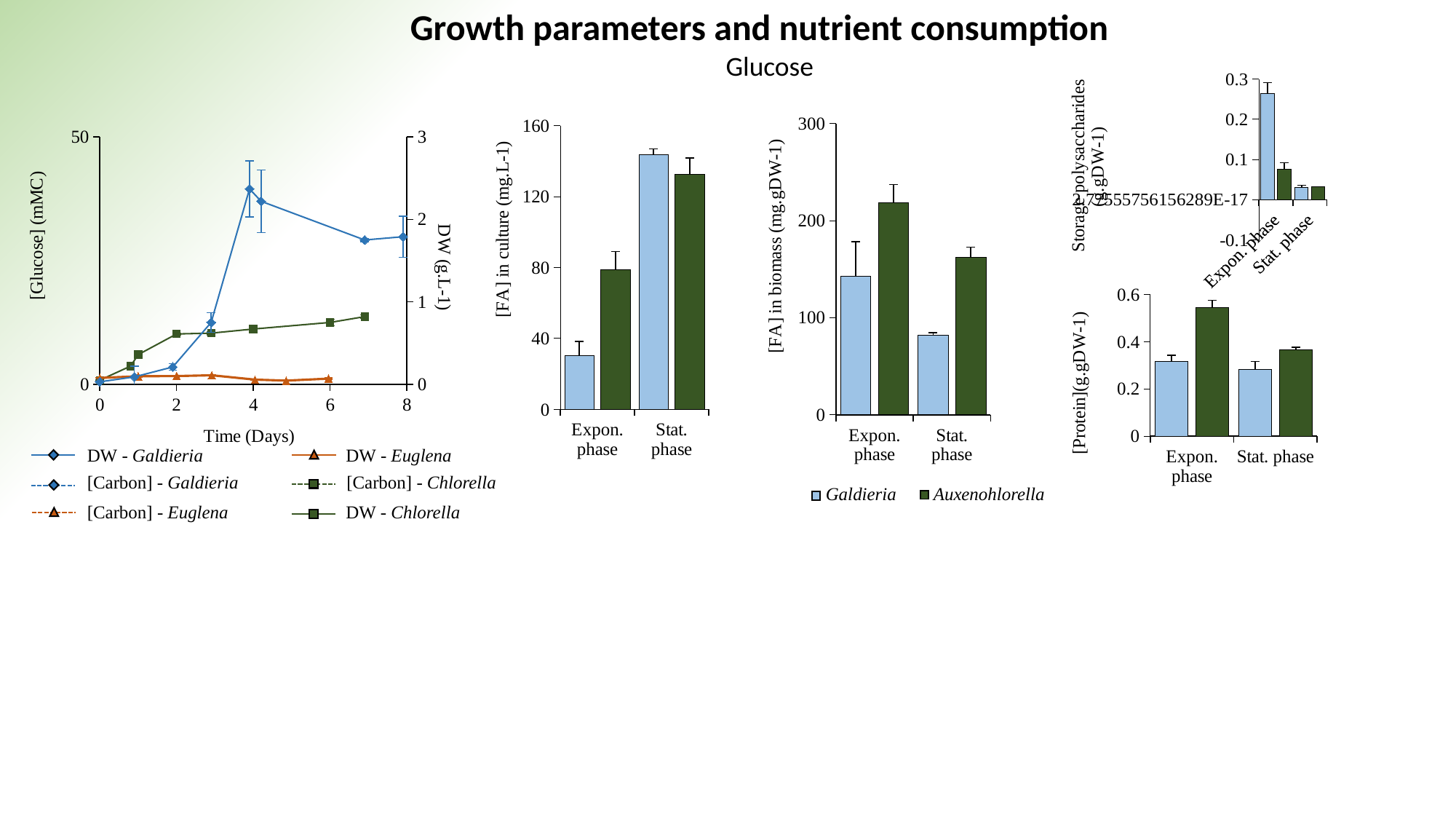
In the Storage polysaccharides (g.gDW-1) bar chart, is the Galdieria value in the Expon. phase greater or less than 0.2? greater In the leftmost line chart, what is the x-axis title? Time (Days) In the [FA] in biomass (mg.gDW-1) bar chart, which species has the larger value in the Expon. phase? Auxenohlorella In the [FA] in culture (mg.L-1) bar chart, is the Galdieria value in the Expon. phase greater or less than 40? less In the [Protein] (g.gDW-1) bar chart, how many phase categories are shown on the x axis? 2 In the [Protein] (g.gDW-1) bar chart, is the Auxenohlorella value in the Expon. phase greater or less than 0.4? greater What kind of chart is the leftmost chart showing [Glucose] and DW against Time (Days)? line chart In the leftmost line chart, how many series does the legend list? 6 In the [FA] in culture (mg.L-1) bar chart, which phase has the higher Galdieria value? Stat. phase